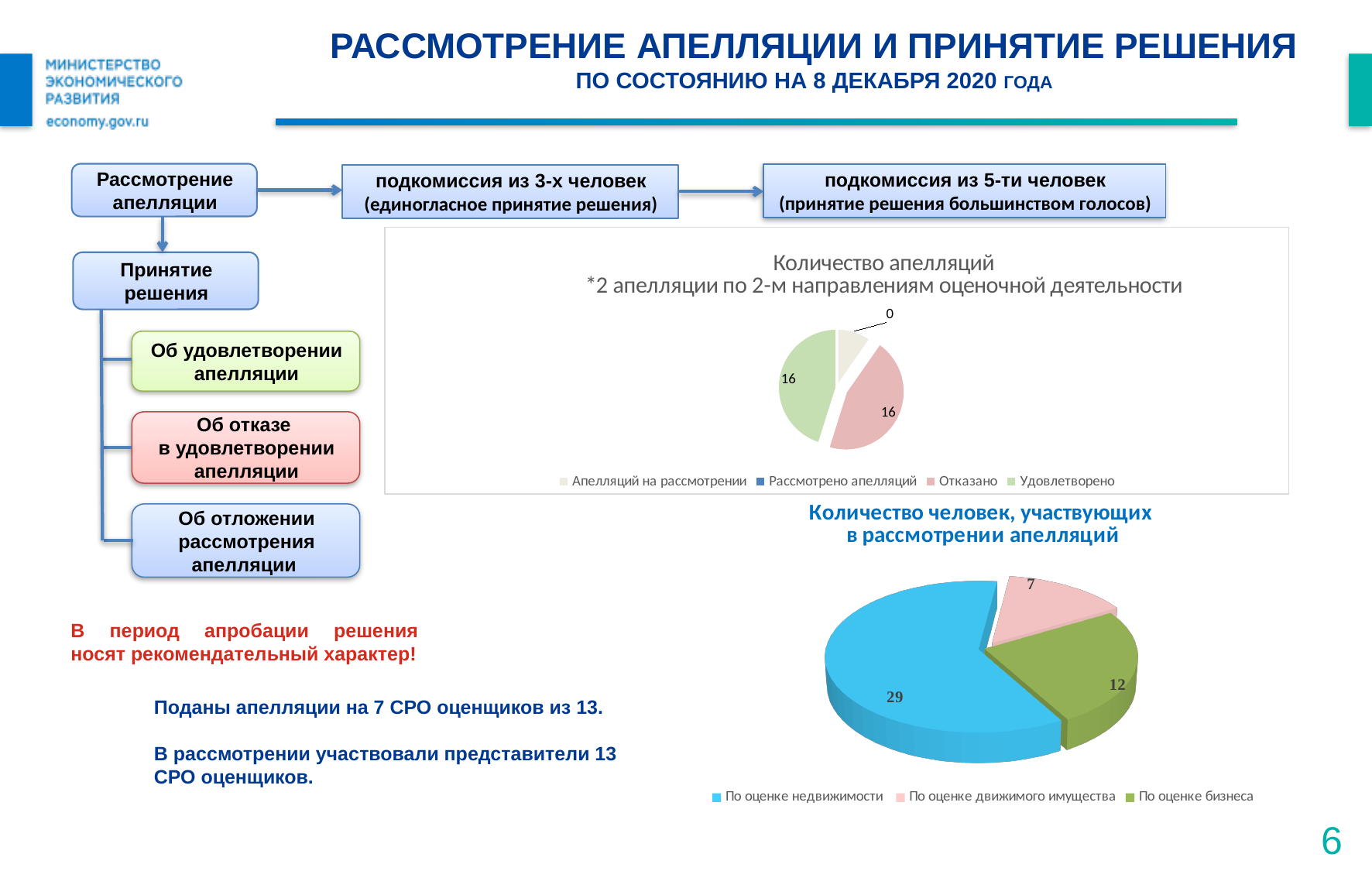
In the chart 'Количество человек, участвующих в рассмотрении апелляций', what is the value for 'По оценке движимого имущества'? 7 In the chart 'Количество человек, участвующих в рассмотрении апелляций', which category has the largest slice? По оценке недвижимости In the chart 'Количество человек, участвующих в рассмотрении апелляций', what is the value for 'По оценке недвижимости'? 29 In the chart 'Количество апелляций', what is the value for 'Удовлетворено'? 16 In the chart 'Количество человек, участвующих в рассмотрении апелляций', what is the value for 'По оценке бизнеса'? 12 In the chart 'Количество человек, участвующих в рассмотрении апелляций', how many categories does the legend list? 3 In the chart 'Количество человек, участвующих в рассмотрении апелляций', what is the difference between the values for 'По оценке недвижимости' and 'По оценке бизнеса'? 17 In the chart 'Количество человек, участвующих в рассмотрении апелляций', what is the total of all slices? 48 In the chart 'Количество апелляций', how many entries does the legend list? 4 What kind of chart is 'Количество человек, участвующих в рассмотрении апелляций'? Pie chart In the chart 'Количество апелляций', what is the value for 'Отказано'? 16 In the chart 'Количество человек, участвующих в рассмотрении апелляций', which category has the smallest slice? По оценке движимого имущества